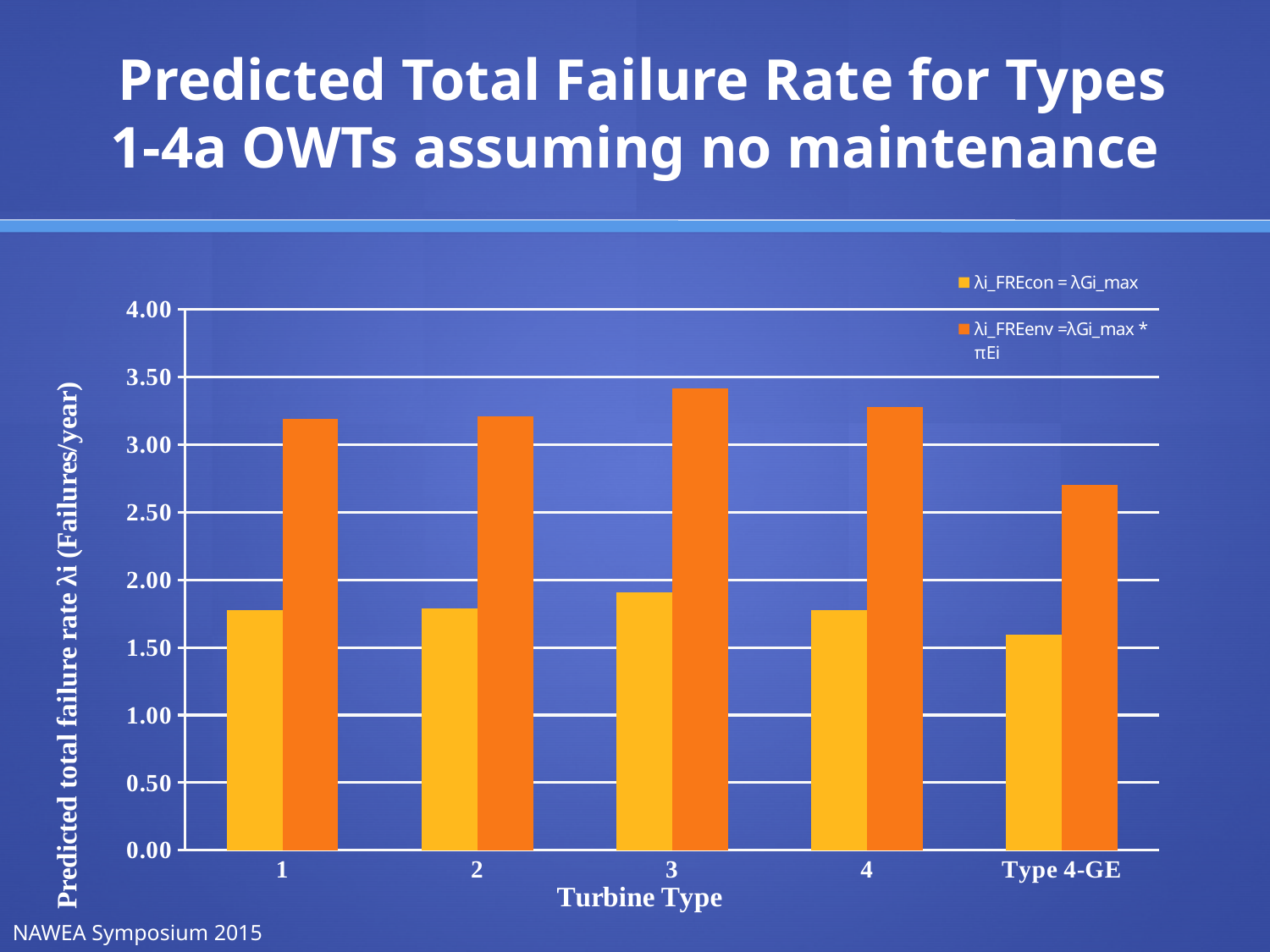
Is the λi_FREenv =λGi_max * πEi value for Type 4-GE greater or less than 3.00? less How many series does the legend list? 2 Which turbine type has the lowest value for the λi_FREcon = λGi_max series? Type 4-GE Is the λi_FREcon = λGi_max value for turbine type 3 greater or less than 2.00? less For the λi_FREenv =λGi_max * πEi series, which is larger: turbine type 3 or Type 4-GE? 3 Which turbine type has the highest value for the λi_FREenv =λGi_max * πEi series? 3 Is the λi_FREcon = λGi_max value for Type 4-GE greater or less than 1.50? greater Which turbine type has the lowest value for the λi_FREenv =λGi_max * πEi series? Type 4-GE How many turbine type categories are shown on the x axis? 5 What is the title of the x axis? Turbine Type What kind of chart is shown on the slide? bar chart